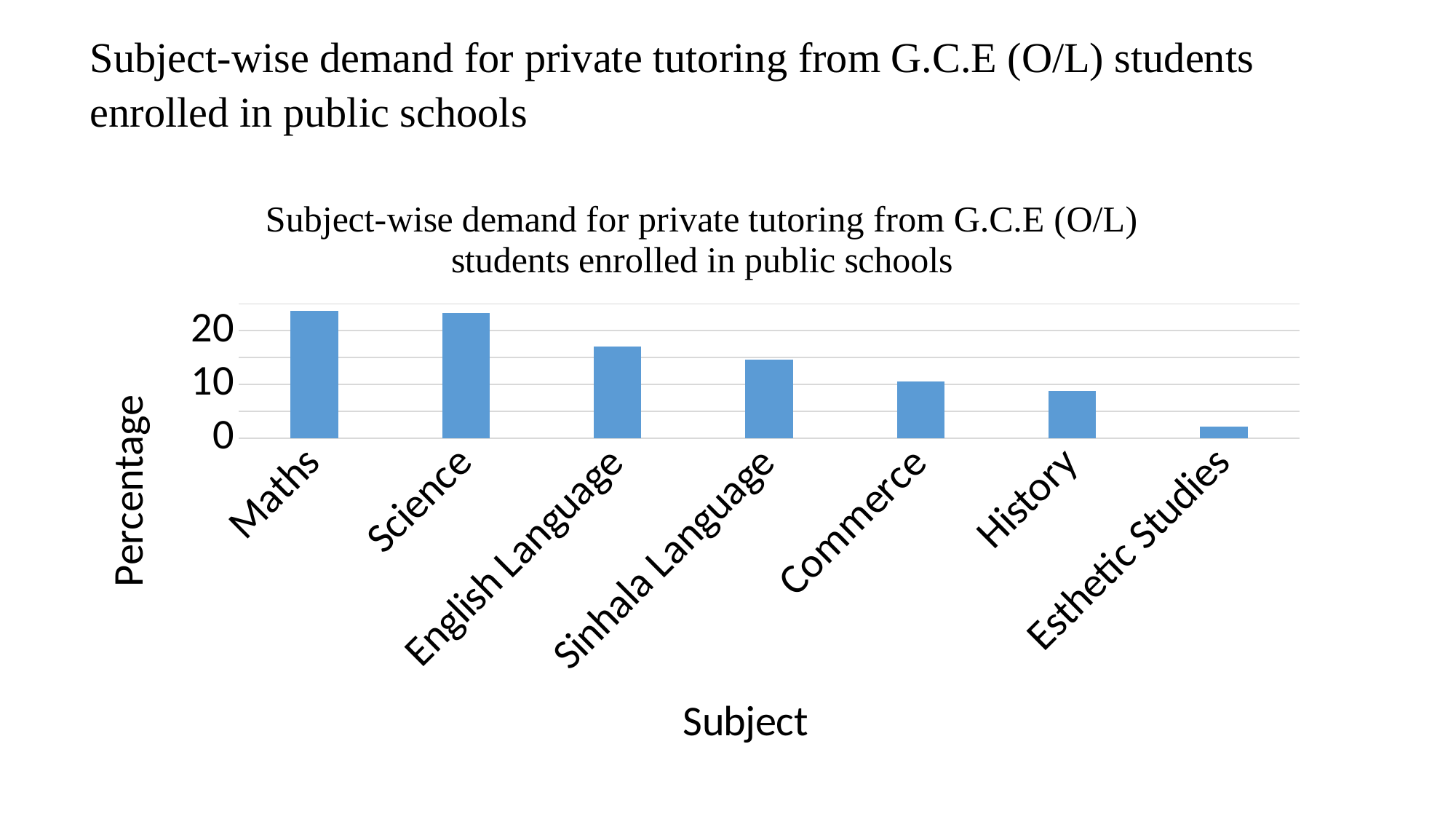
Is the value for Esthetic Studies greater or less than 10? less What kind of chart is shown on the slide? bar chart Is the value for English Language greater or less than 10? greater How many subjects are shown on the x axis of the chart? 7 Is the value for Sinhala Language greater or less than 20? less Which is larger, the value for English Language or the value for Sinhala Language? English Language Do the values rise or fall moving from left to right along the x axis? fall What is the label on the vertical axis of the chart? Percentage Which is larger, the value for Science or the value for Commerce? Science What is the label on the horizontal axis of the chart? Subject Which subject has the lowest demand for private tutoring in the chart? Esthetic Studies